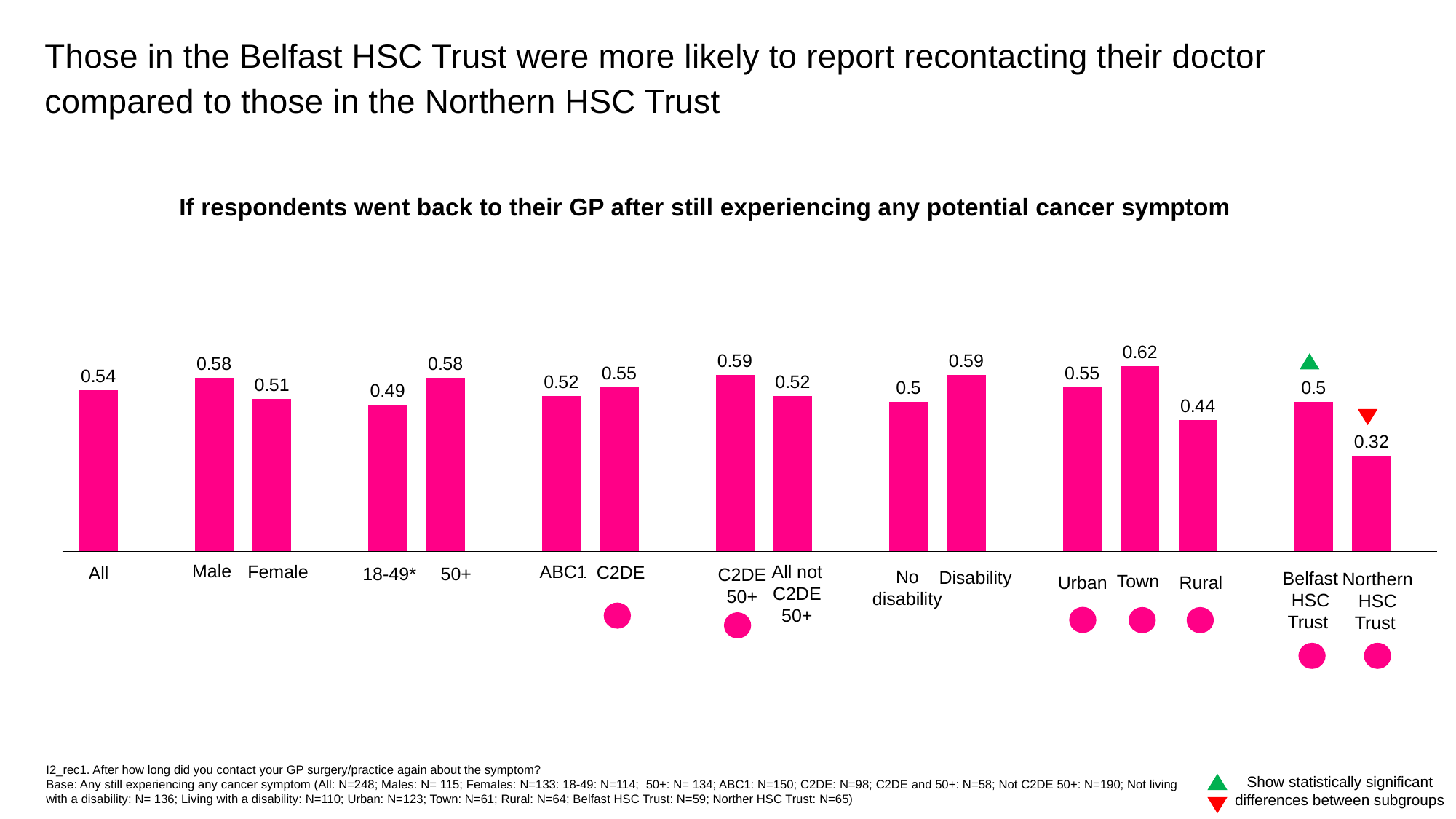
What is the title of the chart? If respondents went back to their GP after still experiencing any potential cancer symptom Which category has the lowest value? Northern HSC Trust What is the difference between the values for Belfast HSC Trust and Northern HSC Trust? 0.18 What is the difference between the values for Male and Female? 0.07 What is the value for Northern HSC Trust? 0.32 Which is larger, the value for Urban or the value for Rural? Urban What is the value for Town? 0.62 What is the value for Disability? 0.59 Which category has the highest value? Town What is the value for All? 0.54 What kind of chart is shown on the slide? Bar chart How many bars are shown in the chart? 16